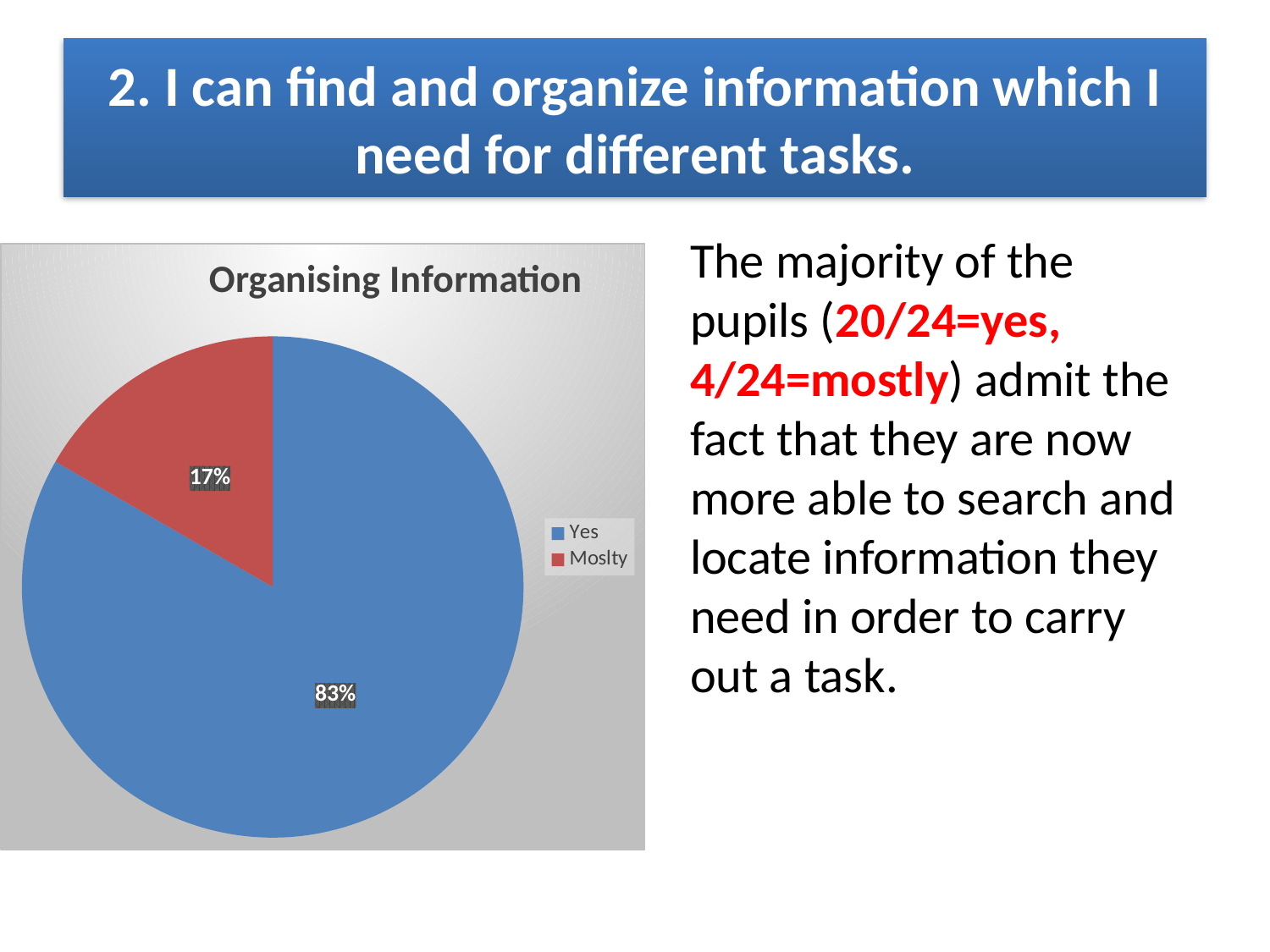
What colour is the Yes slice in the pie chart? blue What type of chart is shown on the slide? pie chart What is the title of the chart? Organising Information What share of the pie does the Yes slice represent? 83% What share of the pie does the Moslty slice represent? 17% What is the difference in percentage points between the Yes slice and the Moslty slice? 66 How many entries does the legend list? 2 Which slice of the pie is the largest? Yes How many slices does the pie chart have? 2 Which slice of the pie is the smallest? Moslty Which is larger, the Yes slice or the Moslty slice? Yes